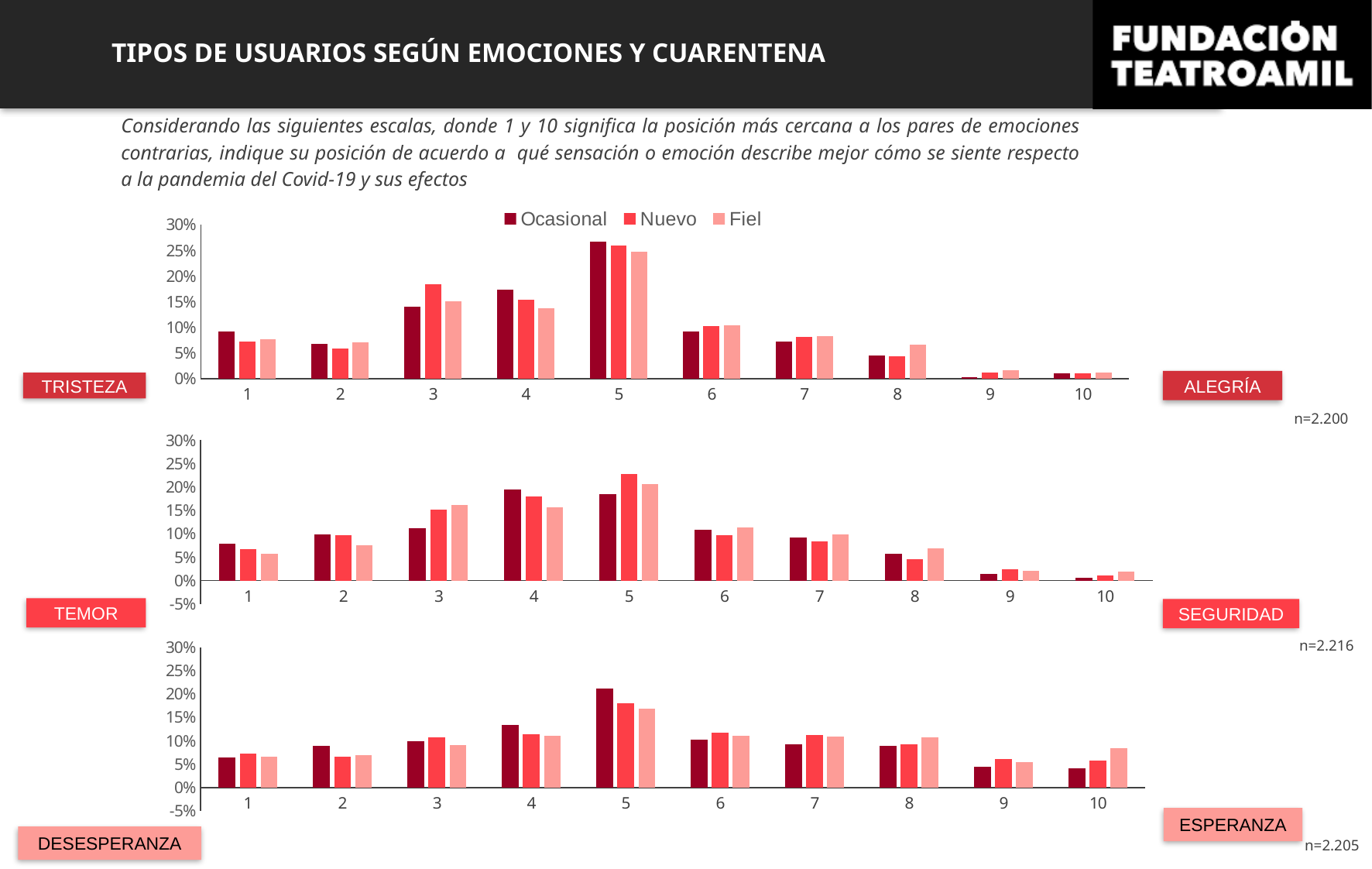
In the top chart (Tristeza–Alegría), at category 3, which is larger: Nuevo or Ocasional? Nuevo In the bottom chart (Desesperanza–Esperanza), at which category is the Ocasional series highest? 5 In the top chart (Tristeza–Alegría), at which category is the Ocasional series highest? 5 In the middle chart (Temor–Seguridad), is the Nuevo value at category 5 greater or less than 20%? greater How many series does the legend list for the charts on the slide? 3 What sample size (n) is shown for the middle chart (Temor–Seguridad)? n=2.216 How many categories are shown on the x axis of the middle chart (Temor–Seguridad)? 10 In the top chart (Tristeza–Alegría), is the Ocasional value at category 5 greater or less than 20%? greater What kind of chart is the top chart (Tristeza–Alegría)? Bar chart In the bottom chart (Desesperanza–Esperanza), is the Ocasional value at category 5 greater or less than 15%? greater In the middle chart (Temor–Seguridad), at category 4, which is larger: Ocasional or Fiel? Ocasional